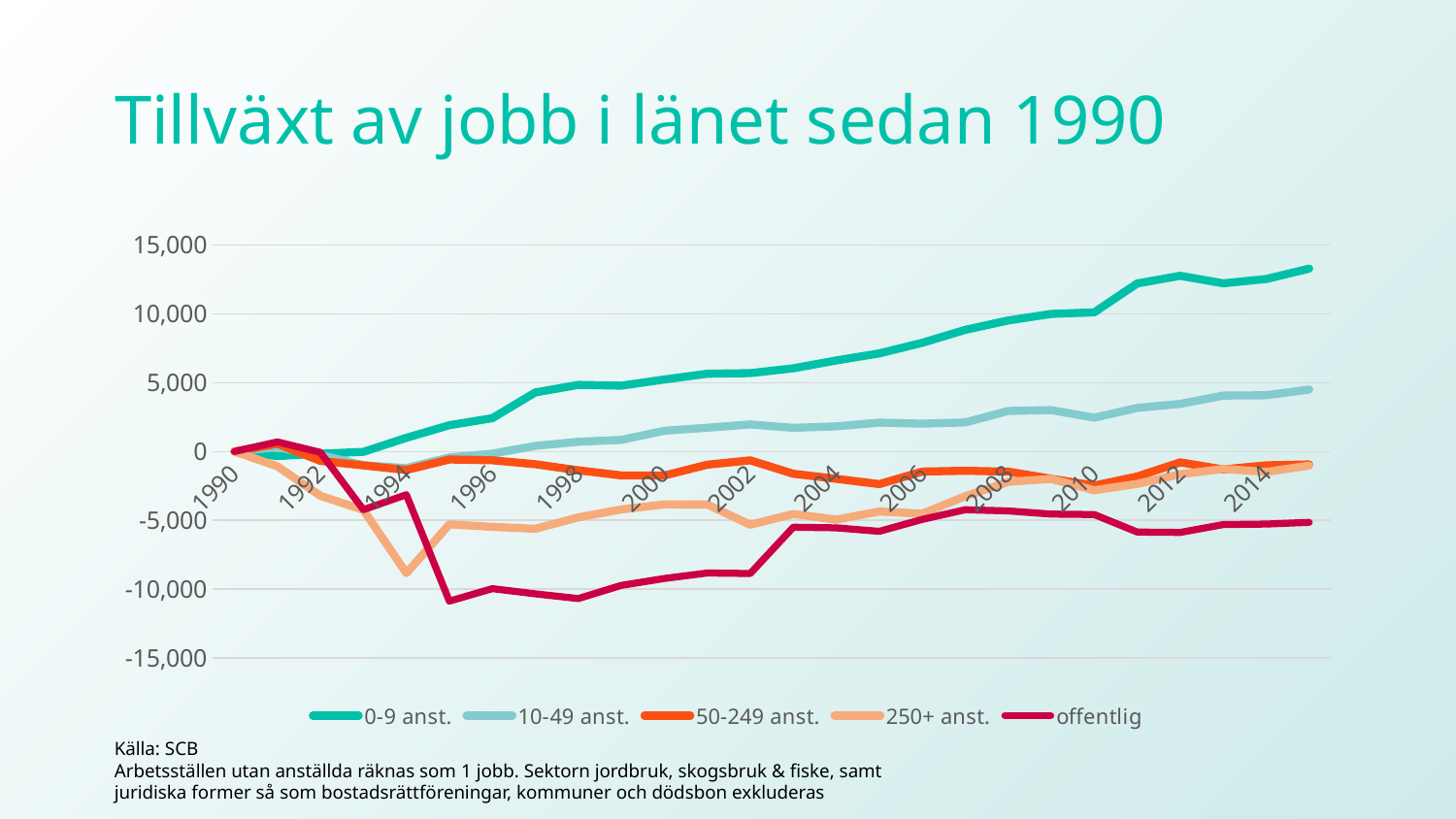
What kind of chart is shown on the slide? line chart What is the title of the chart? Tillväxt av jobb i länet sedan 1990 Is the value for offentlig in 1996 greater or less than -5,000? less How many series does the legend list? 5 Is the value for 250+ anst. in 1994 greater or less than -5,000? less Which series reaches the lowest value anywhere on the chart? offentlig Which series has the highest value at the right end of the chart (2014)? 0-9 anst. How many year labels are shown on the x axis? 13 In 2014, which series is higher: 10-49 anst. or 250+ anst.? 10-49 anst. Is the value for 0-9 anst. in 2014 greater or less than 10,000? greater Does the 0-9 anst. series generally rise or fall from 1990 to 2014? rise